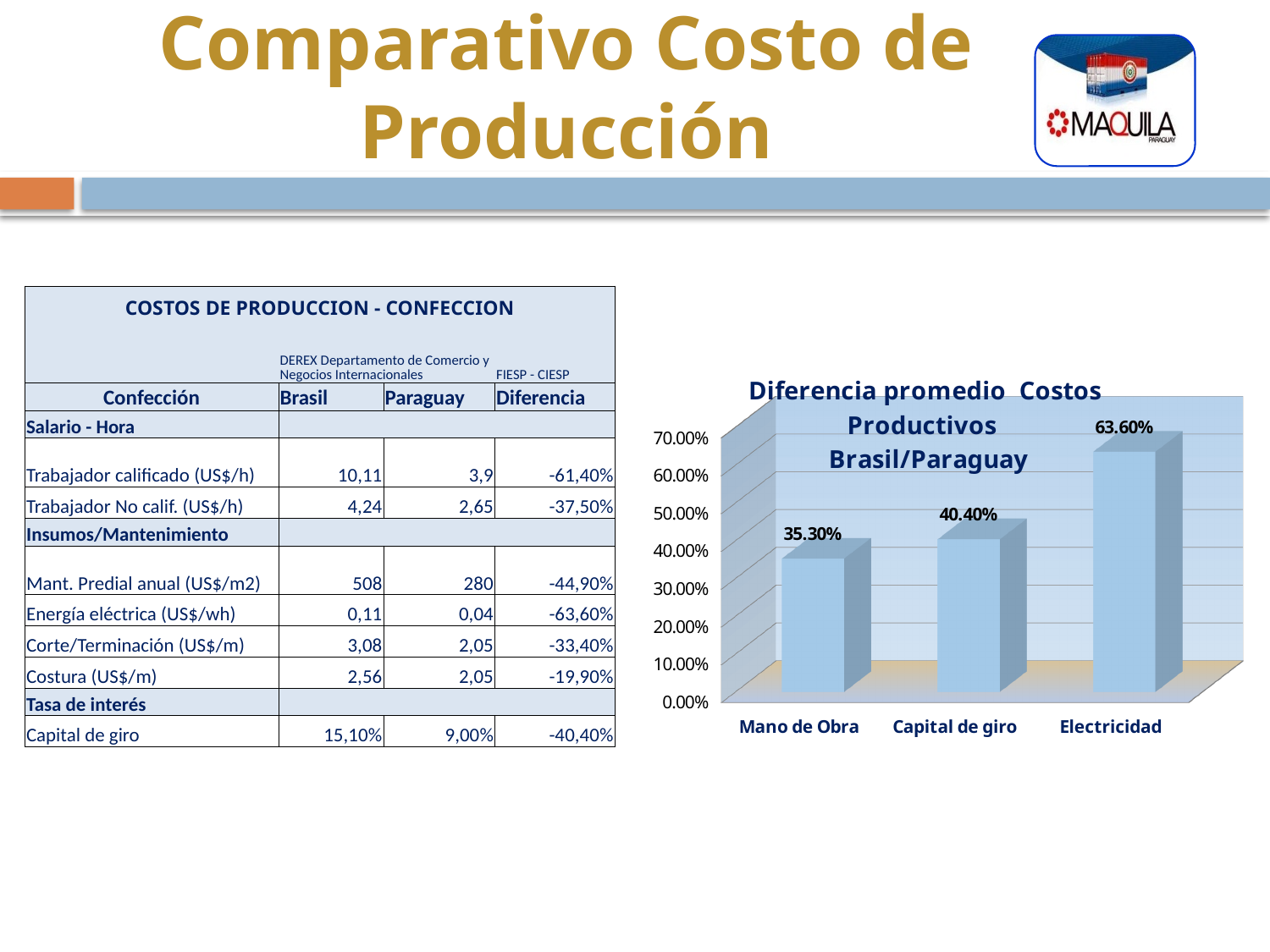
What is the value for Capital de giro in the chart? 40.40% What is the difference between the values for Electricidad and Mano de Obra? 28.30% What is the title of the chart? Diferencia promedio Costos Productivos Brasil/Paraguay Which category has the lowest value in the chart? Mano de Obra Is the value for Electricidad greater or less than 60.00%? greater What kind of chart is shown on the slide? bar chart What is the value for Electricidad in the chart? 63.60% What is the difference between the values for Capital de giro and Mano de Obra? 5.10% What is the value for Mano de Obra in the chart? 35.30% How many categories are shown in the chart? 3 Which is larger, the value for Capital de giro or the value for Electricidad? Electricidad Which category has the highest value in the chart? Electricidad